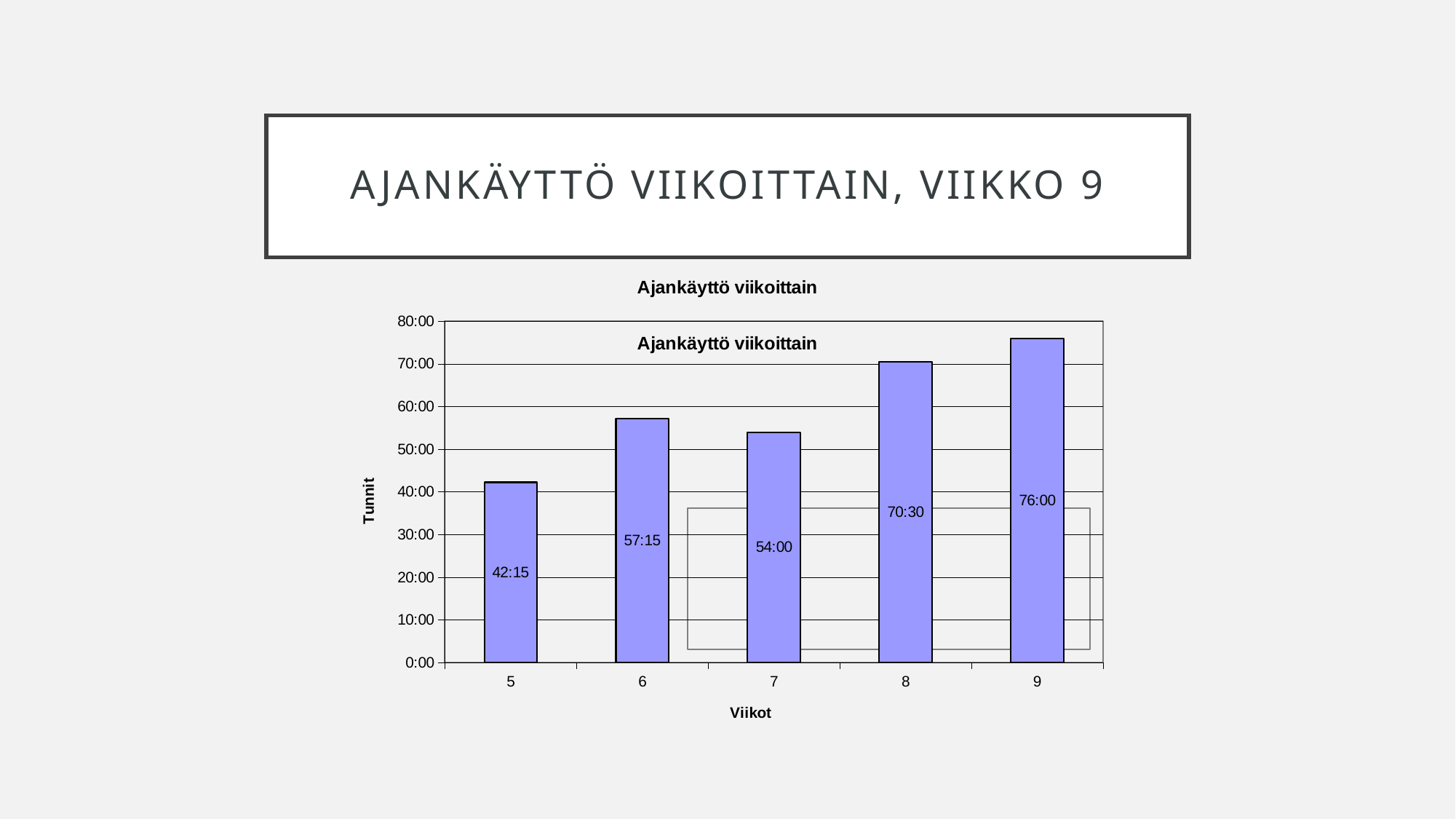
Does the value rise or fall from week 6 to week 7? fall Is the value for week 8 greater or less than 60:00? greater What is the difference between the values for week 9 and week 8? 5:30 Which week has the highest value? 9 What is the value for week 7? 54:00 What kind of chart is shown on the slide? bar chart How many weeks are shown on the x axis? 5 Which week has the lowest value? 5 What is the value for week 8? 70:30 Which is larger, the value for week 6 or the value for week 7? week 6 What is the value for week 5? 42:15 What is the difference between the values for week 6 and week 7? 3:15